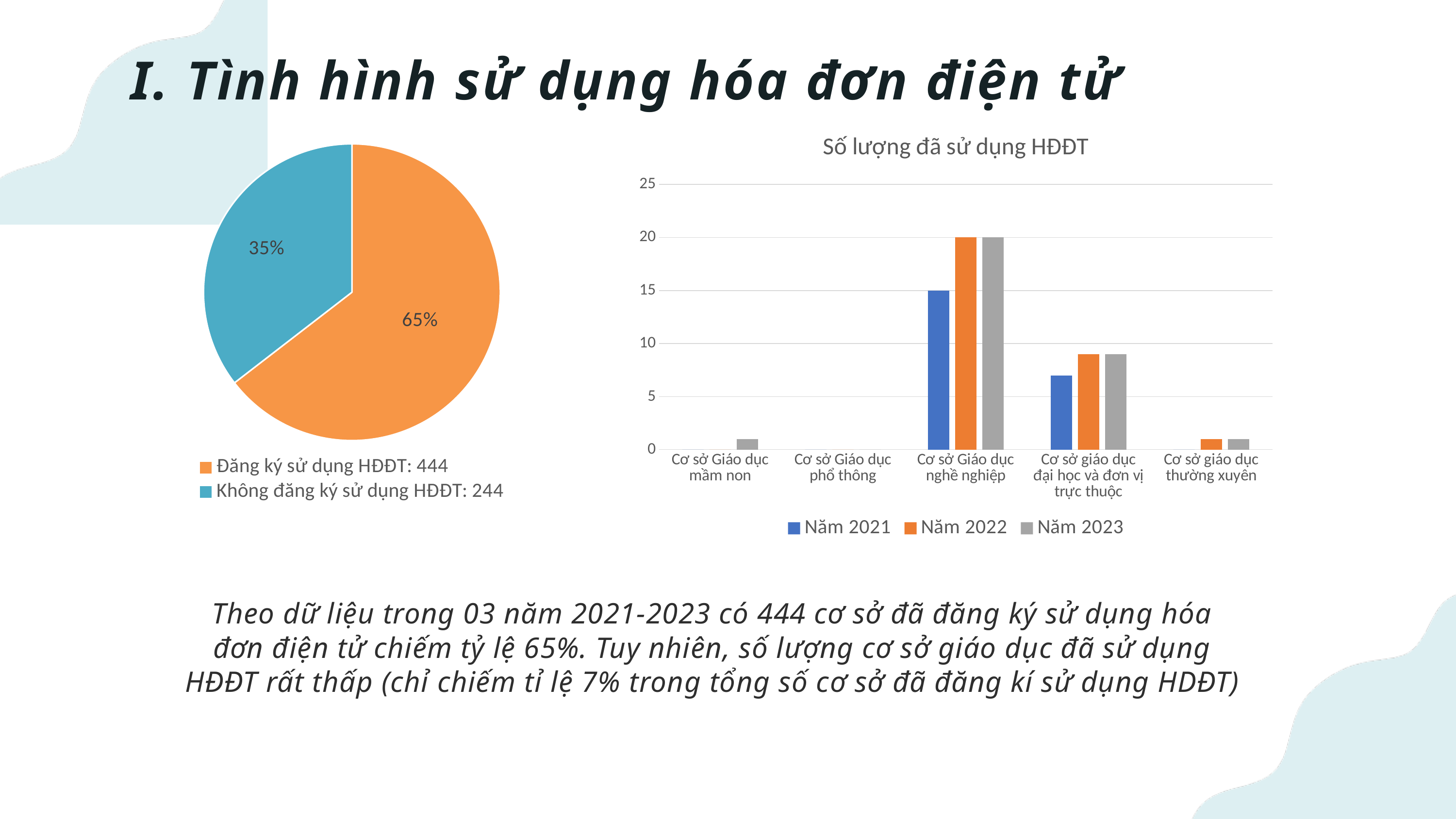
In the pie chart on the left, what number is shown in the legend for 'Không đăng ký sử dụng HĐĐT'? 244 In the chart 'Số lượng đã sử dụng HĐĐT', is the value for 'Năm 2021' in 'Cơ sở giáo dục đại học và đơn vị trực thuộc' greater or less than 10? less In the chart 'Số lượng đã sử dụng HĐĐT', what is the value for 'Năm 2022' in 'Cơ sở Giáo dục nghề nghiệp'? 20 In the chart 'Số lượng đã sử dụng HĐĐT', what is the value for 'Năm 2021' in 'Cơ sở Giáo dục nghề nghiệp'? 15 What kind of chart is 'Số lượng đã sử dụng HĐĐT'? Bar chart In the pie chart on the left, what share of the pie does 'Không đăng ký sử dụng HĐĐT' take? 35% In the chart 'Số lượng đã sử dụng HĐĐT', which category has the highest values? Cơ sở Giáo dục nghề nghiệp In the pie chart on the left, what is the difference between the legend values for 'Đăng ký sử dụng HĐĐT' and 'Không đăng ký sử dụng HĐĐT'? 200 In the pie chart on the left, which slice is larger, 'Đăng ký sử dụng HĐĐT' or 'Không đăng ký sử dụng HĐĐT'? Đăng ký sử dụng HĐĐT In the pie chart on the left, what share of the pie does 'Đăng ký sử dụng HĐĐT' take? 65% In the chart 'Số lượng đã sử dụng HĐĐT', how many categories are shown on the x axis? 5 In the chart 'Số lượng đã sử dụng HĐĐT', how many series does the legend list? 3